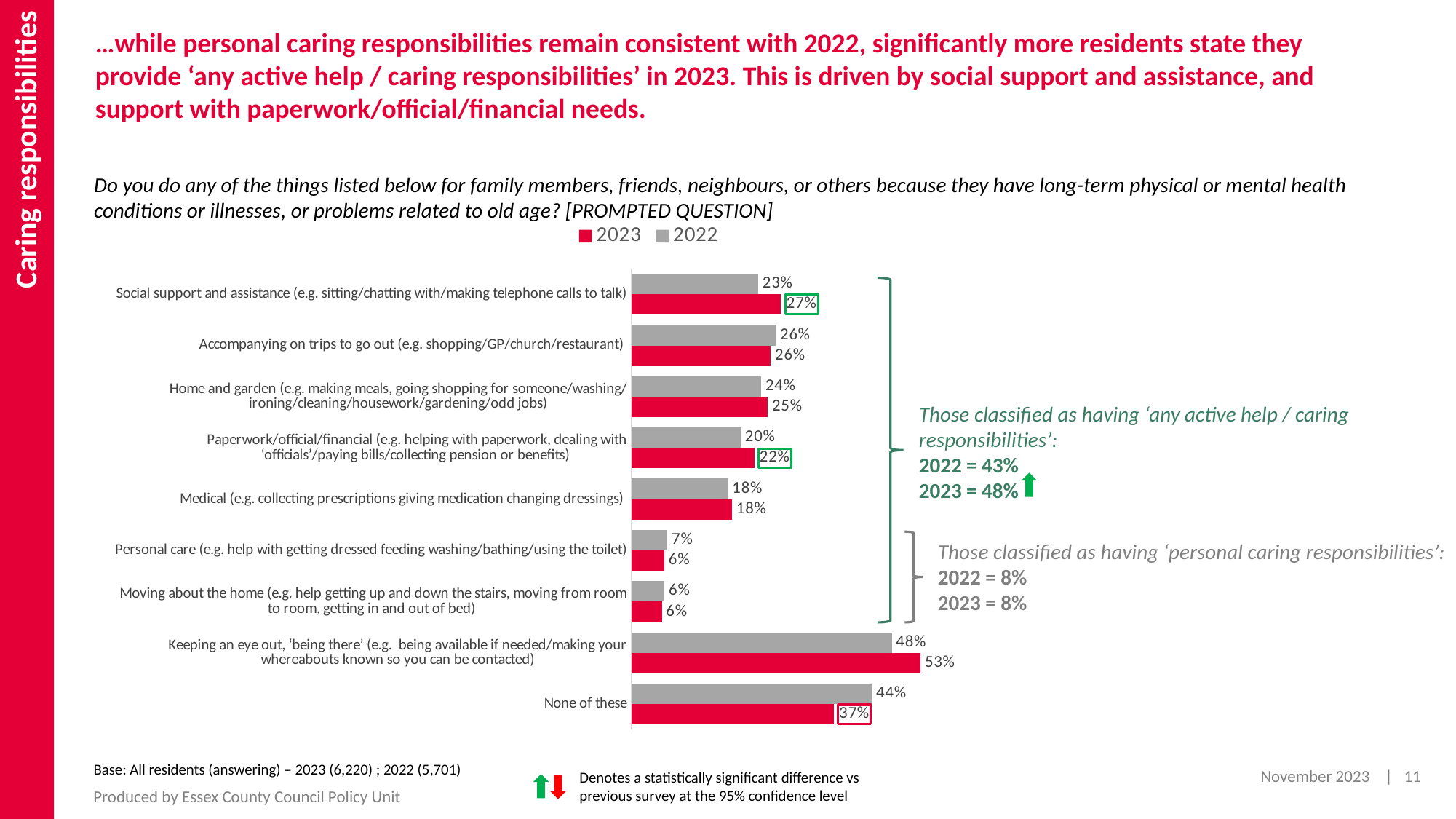
What is the difference between the 2023 and 2022 values for 'Keeping an eye out, being there'? 5% What is the 2023 value for 'Paperwork/official/financial'? 22% What is the 2022 value for 'None of these'? 44% Which category has the highest 2023 value? Keeping an eye out, 'being there' Which is larger for 'Personal care': the 2022 value or the 2023 value? 2022 How many categories are shown in the chart? 9 Which category has the lowest 2022 value? Moving about the home What is the difference between the 2023 and 2022 values for 'None of these'? 7% What kind of chart is shown on the slide? Bar chart What is the 2023 value for 'Social support and assistance'? 27% How many series does the legend list? 2 Which colour represents the 2023 series in the chart? Red